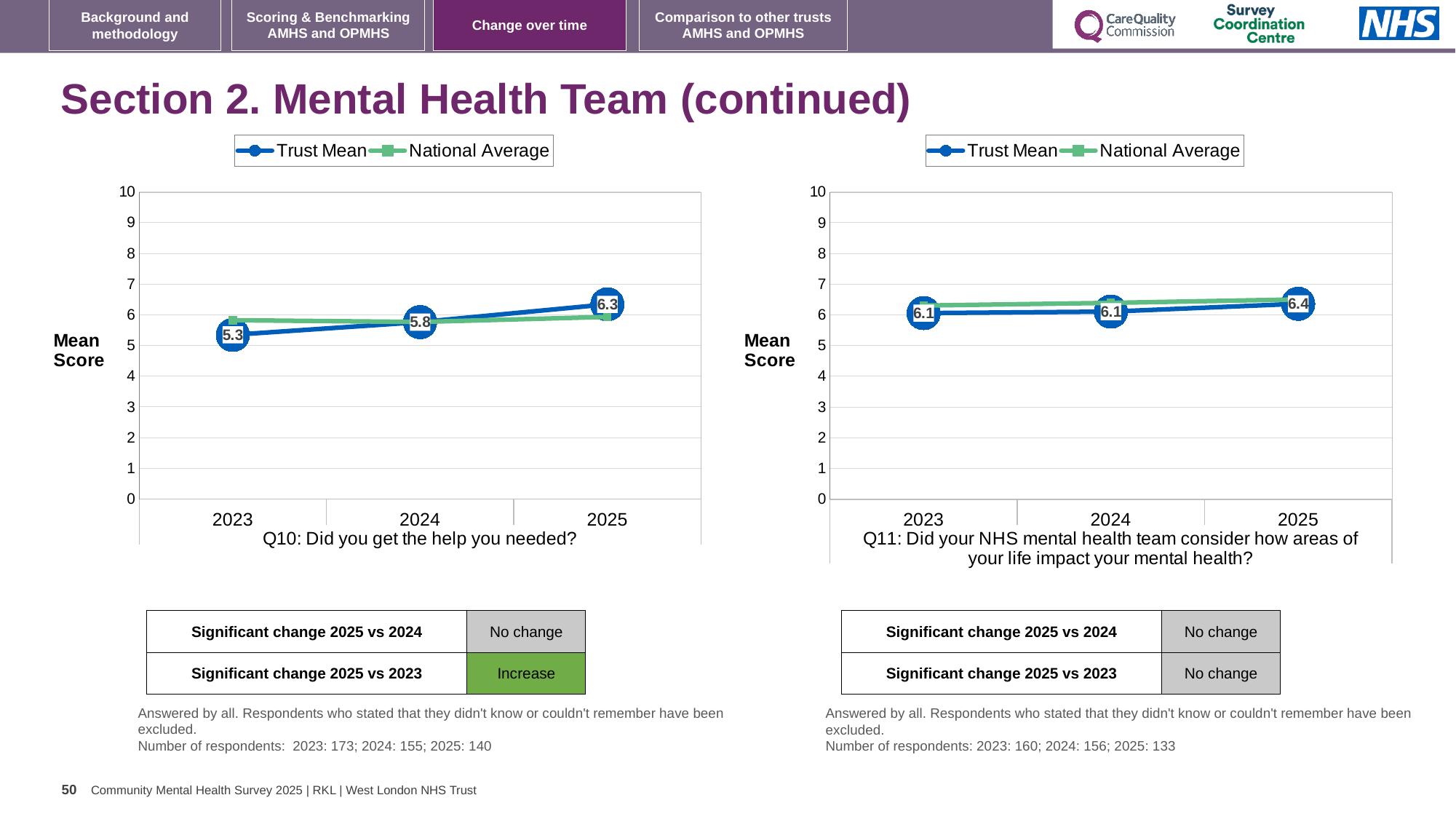
In the Q10 chart (left), by how much did the Trust Mean change from 2023 to 2025? 1.0 In the Q10 chart (left), is the National Average for 2023 greater or less than 5? greater In the Q10 chart (left), does the Trust Mean rise or fall from 2023 to 2025? rise In the Q10 chart (left), which year has the lowest Trust Mean? 2023 In the Q10 chart (left), what is the Trust Mean for 2025? 6.3 In the Q10 chart (left), what is the Trust Mean for 2023? 5.3 In the Q11 chart (right), which year has the highest Trust Mean? 2025 In the Q11 chart (right), what is the Trust Mean for 2024? 6.1 In the Q11 chart (right), what is the difference between the Trust Mean in 2025 and in 2024? 0.3 What kind of chart is the Q10 chart (left)? line chart How many series does the legend of the Q11 chart (right) list? 2 In the Q11 chart (right), what is the Trust Mean for 2025? 6.4